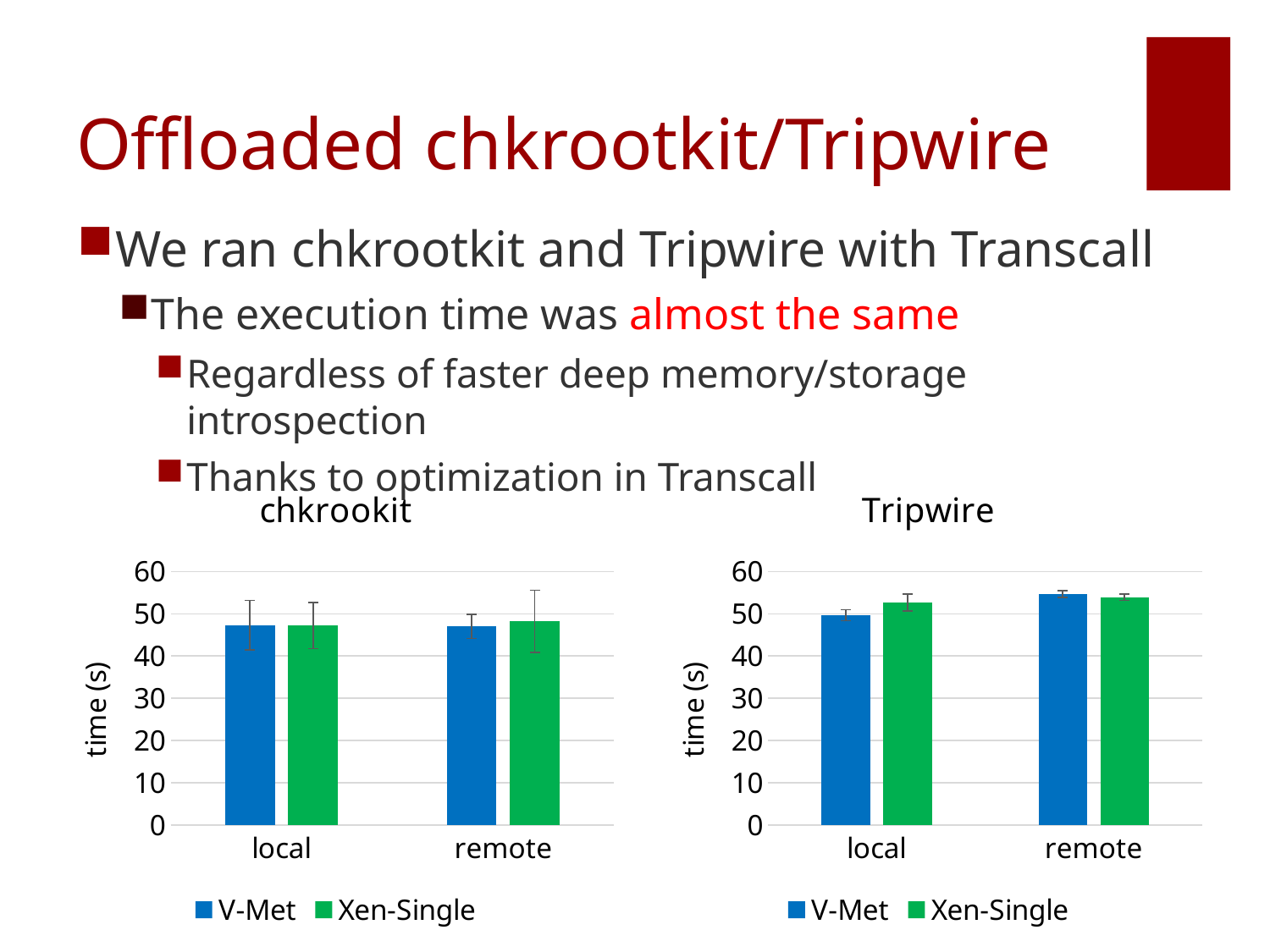
How many categories are shown on the x axis of the chkrookit chart? 2 In the Tripwire chart, is the value for Xen-Single at remote greater or less than 60? less In the Tripwire chart, which series has the larger value at local: V-Met or Xen-Single? Xen-Single What is the y-axis label of the Tripwire chart? time (s) In the Tripwire chart, is the value for Xen-Single at local greater or less than 50? greater In the Tripwire chart, which is larger for V-Met: local or remote? remote In the Tripwire chart, is the value for V-Met at remote greater or less than 50? greater What is the title of the chart on the right of the slide? Tripwire How many series does the legend of the Tripwire chart list? 2 What kind of chart is the chkrookit chart on the left? bar chart